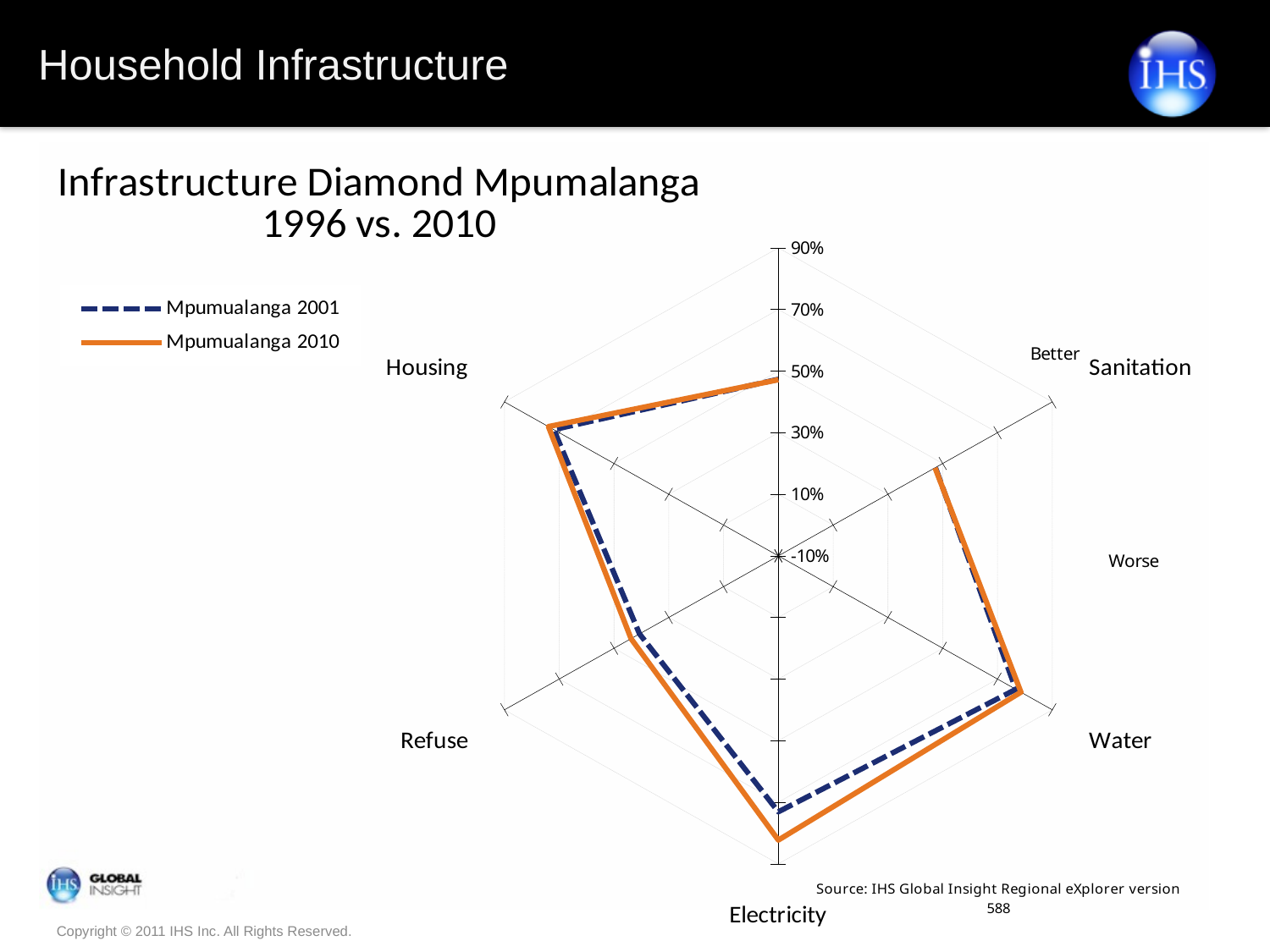
Is the Housing value for Mpumualanga 2010 greater or less than 50%? greater Is the Sanitation value for Mpumualanga 2010 greater or less than 30%? greater Is the Water value for Mpumualanga 2010 greater or less than 50%? greater Which series is drawn with a dashed line? Mpumualanga 2001 For Mpumualanga 2010, which is larger, the Water value or the Sanitation value? Water What kind of chart is shown on the slide? Radar chart What are the two series named in the legend? Mpumualanga 2001 and Mpumualanga 2010 For Electricity, which series has the larger value, Mpumualanga 2001 or Mpumualanga 2010? Mpumualanga 2010 How many categories (axes) does the radar chart have? 5 How many series does the legend list? 2